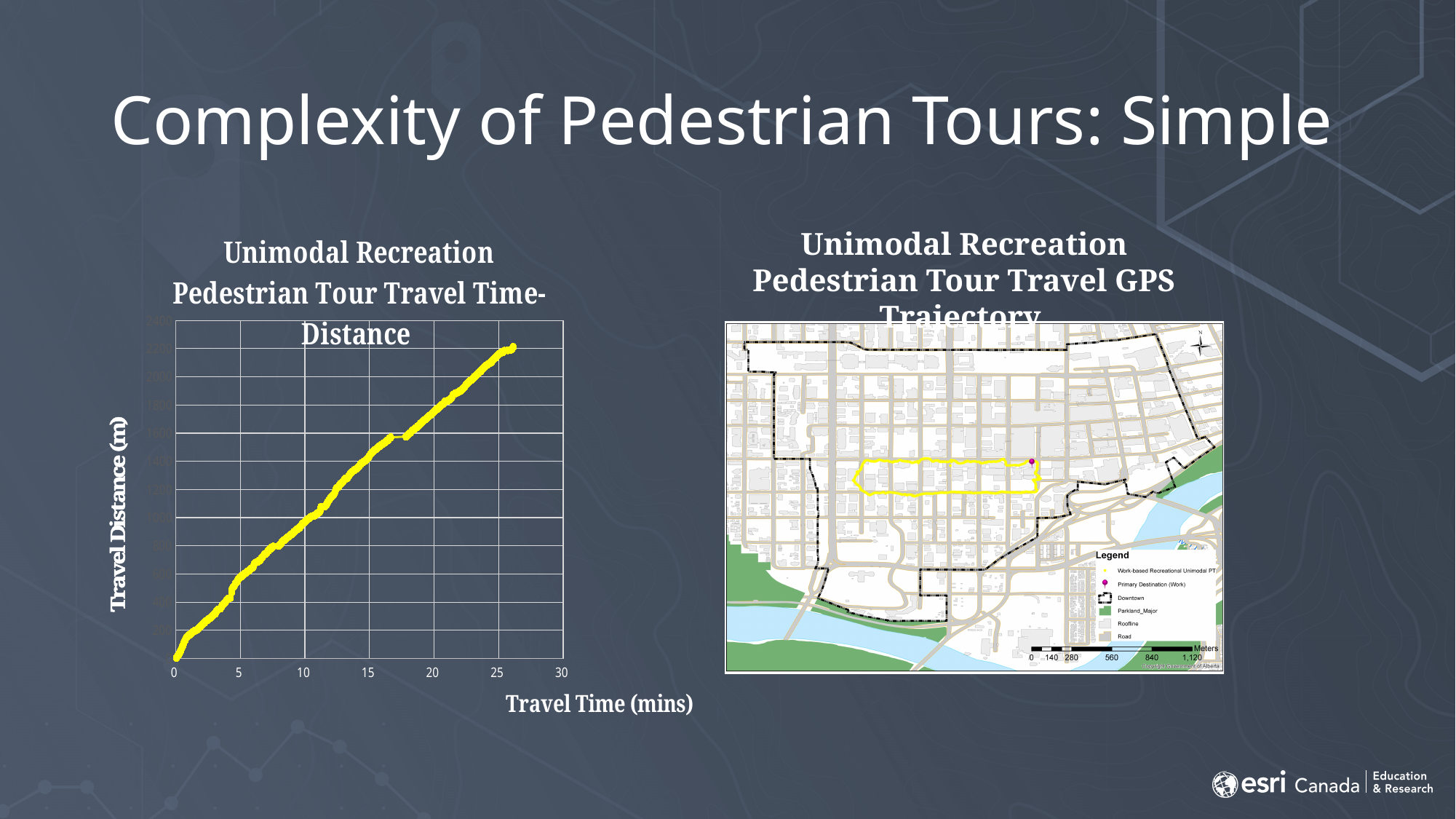
What is the y-axis title of the Unimodal Recreation Pedestrian Tour Travel Time-Distance chart? Travel Distance (m) In the Unimodal Recreation Pedestrian Tour Travel Time-Distance chart, is the travel time of the last plotted point greater or less than 25? greater In the Unimodal Recreation Pedestrian Tour Travel Time-Distance chart, is the travel distance at a travel time of 15 minutes greater or less than 1000? greater In the Unimodal Recreation Pedestrian Tour Travel Time-Distance chart, is the travel time of the last plotted point greater or less than 30? less What is the x-axis title of the Unimodal Recreation Pedestrian Tour Travel Time-Distance chart? Travel Time (mins) What kind of chart is the Unimodal Recreation Pedestrian Tour Travel Time-Distance chart? scatter chart In the Unimodal Recreation Pedestrian Tour Travel Time-Distance chart, does travel distance rise or fall as travel time increases? rise